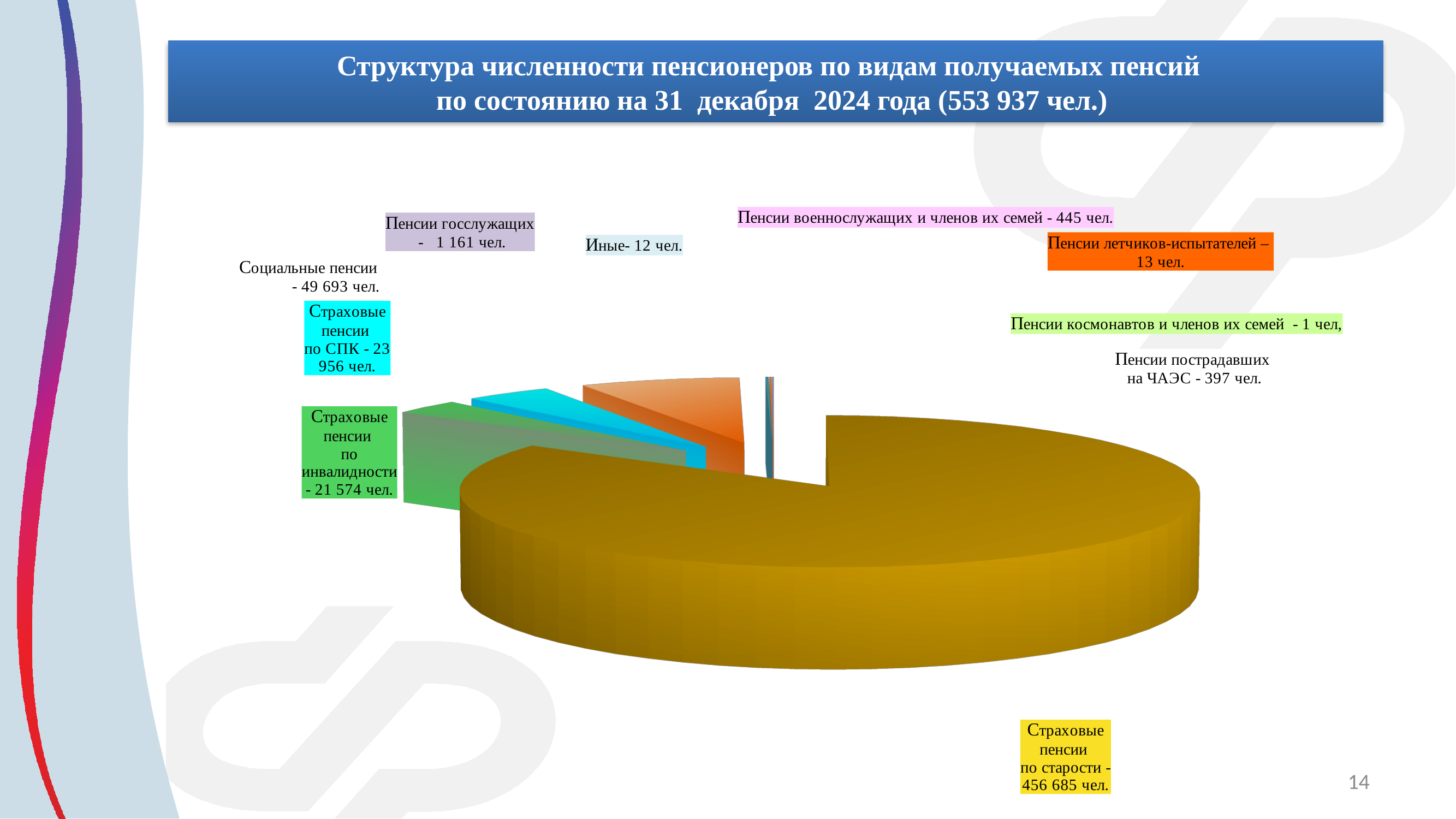
What is the value for Пенсии летчиков-испытателей? 13 чел. How many people receive Страховые пенсии по старости according to the chart? 456 685 чел. What is the difference between Пенсии военнослужащих и членов их семей and Пенсии пострадавших на ЧАЭС? 48 чел. How many people receive Пенсии пострадавших на ЧАЭС? 397 чел. What kind of chart is shown on the slide? pie chart Which pension type has the smallest number of recipients? Пенсии космонавтов и членов их семей How many pension categories are shown in the chart? 10 Which is larger: Страховые пенсии по СПК or Страховые пенсии по инвалидности? Страховые пенсии по СПК What is the total number of pensioners stated in the chart title? 553 937 чел. Which pension type has the largest number of recipients? Страховые пенсии по старости What is the difference between Социальные пенсии and Страховые пенсии по СПК? 25 737 чел. What is the value shown for Социальные пенсии? 49 693 чел.